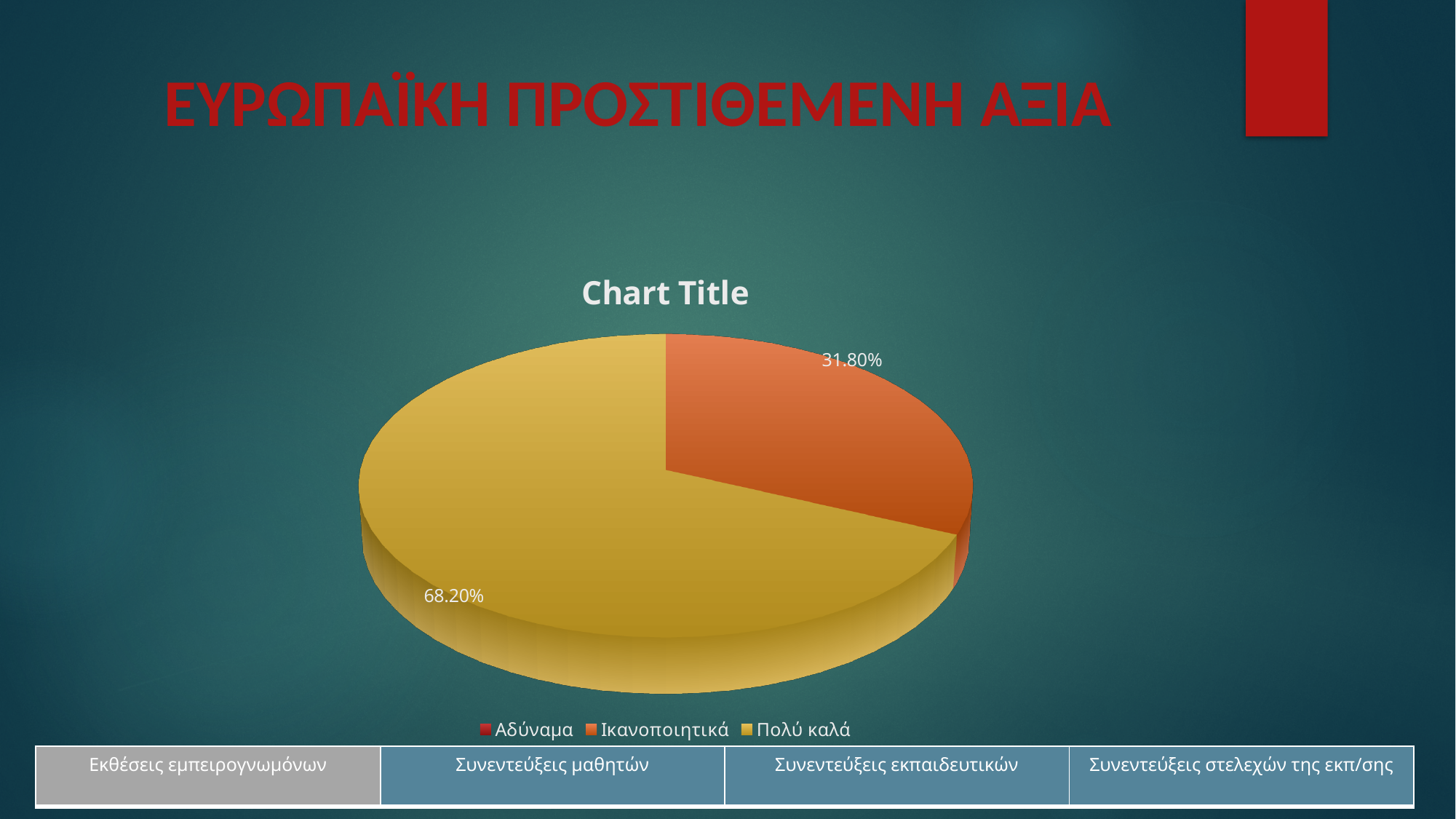
What is the difference between the Πολύ καλά and Ικανοποιητικά percentages? 36.40% How many entries does the legend list? 3 Which is larger, the Ικανοποιητικά slice or the Πολύ καλά slice? Πολύ καλά Which category has the largest slice of the pie? Πολύ καλά What percentage is shown for the Πολύ καλά slice? 68.20% Is the value for Πολύ καλά greater or less than 50%? greater How many slices have a percentage label printed on the pie? 2 What colour is the Πολύ καλά slice? yellow What percentage is shown for the Ικανοποιητικά slice? 31.80% What is the title of the chart? Chart Title What do the two labelled slices add up to? 100.00% What kind of chart is shown on the slide? pie chart